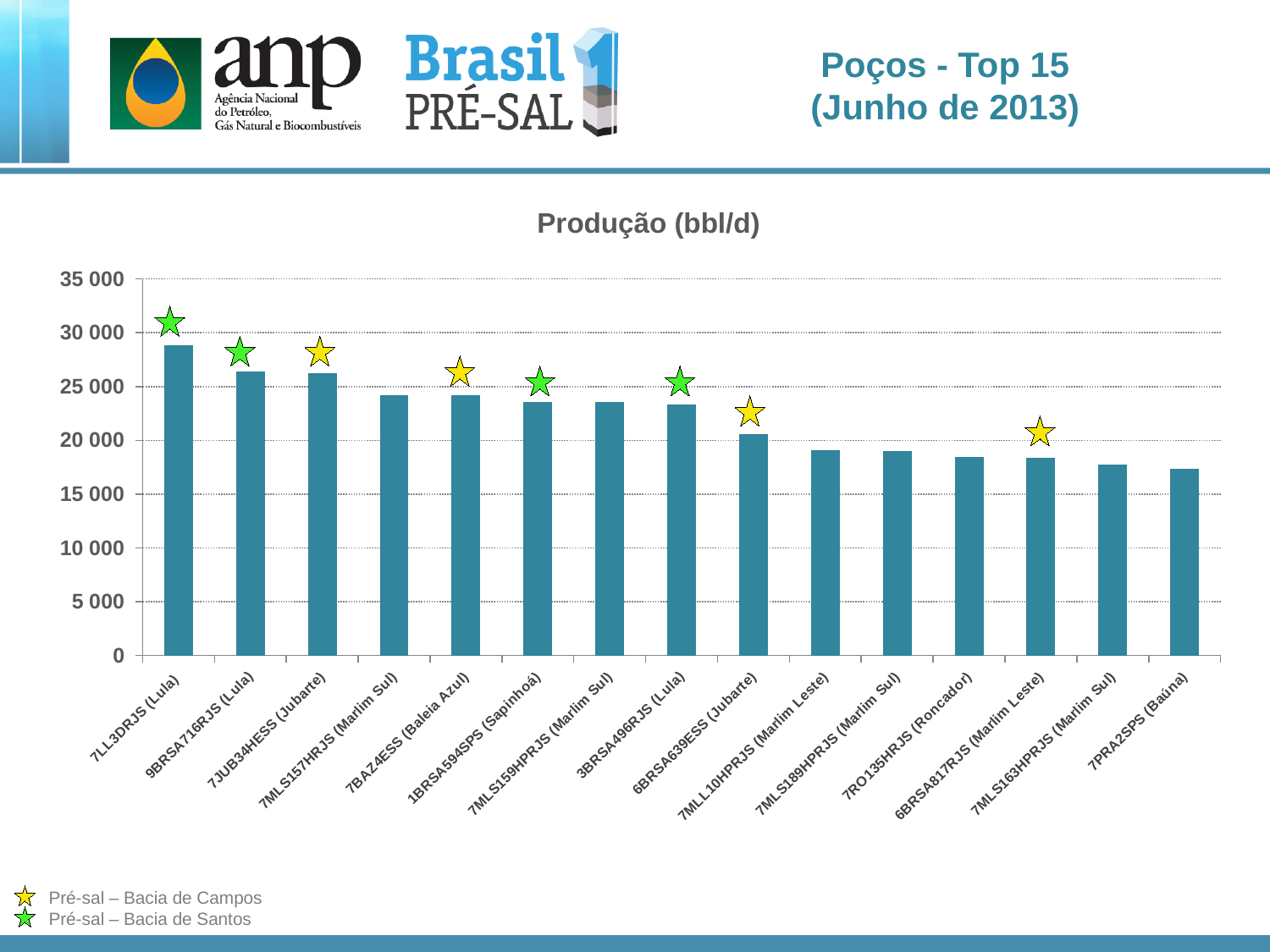
How many wells (bars) are shown in the chart? 15 What kind of chart is shown on the slide? bar chart Which has higher production, 3BRSA496RJS (Lula) or 6BRSA639ESS (Jubarte)? 3BRSA496RJS (Lula) Which well has the highest production in the chart? 7LL3DRJS (Lula) Which has higher production, 7LL3DRJS (Lula) or 9BRSA716RJS (Lula)? 7LL3DRJS (Lula) Is the production for 7MLS157HRJS (Marlim Sul) greater or less than 25 000? less Is the production for 7RO135HRJS (Roncador) greater or less than 20 000? less Is the production for 1BRSA594SPS (Sapinhoá) greater or less than 20 000? greater What is the title of the chart? Produção (bbl/d) Do the production values rise or fall from left to right along the x axis? fall